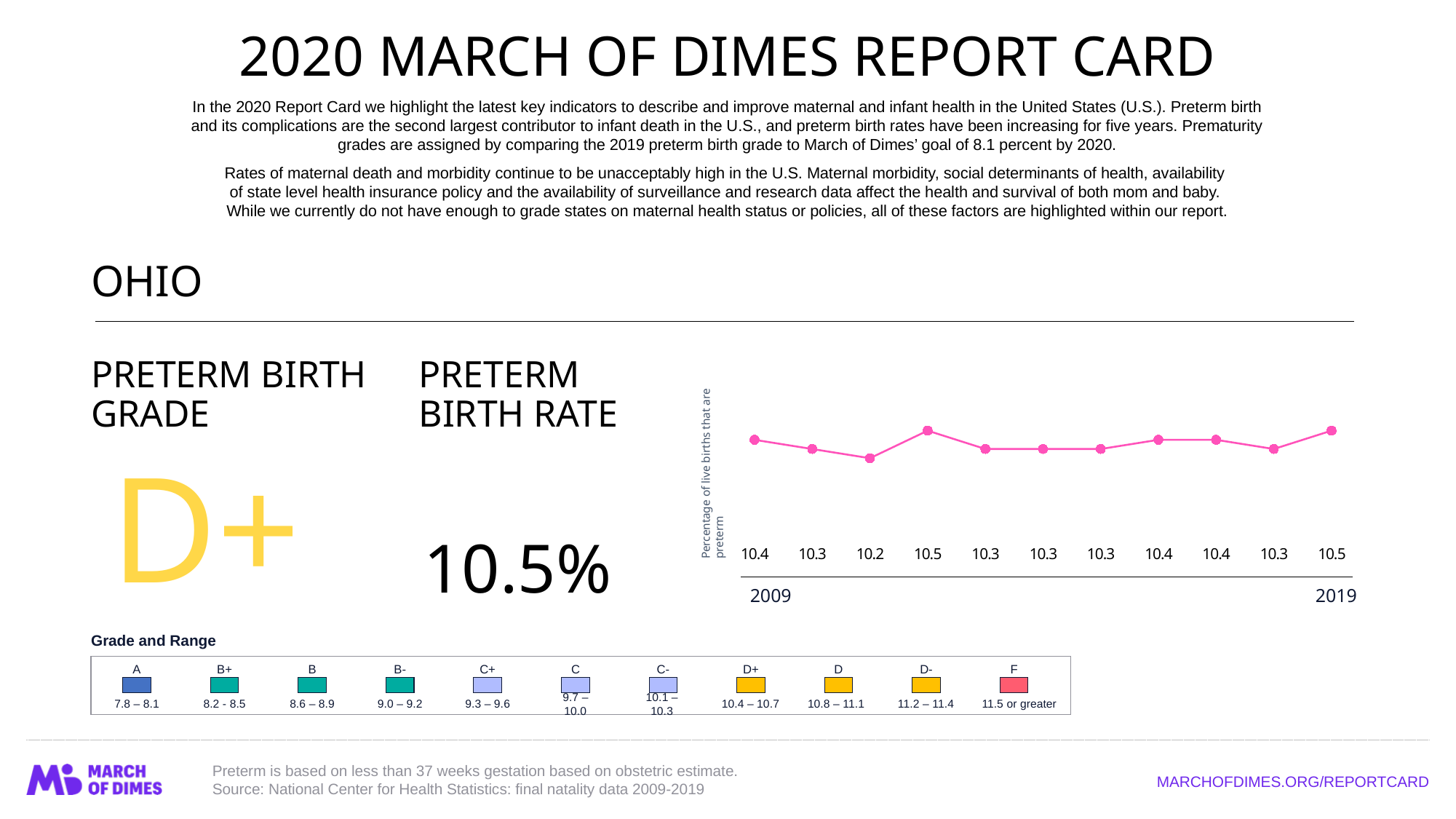
Which is larger in the line chart, the value for 2009 or the value for 2019? 2019 What is the lowest value plotted in the line chart? 10.2 What is the value of the third data point (from the left) in the line chart? 10.2 What is the difference between the 2019 value and the 2009 value in the line chart? 0.1 What is the preterm birth rate value plotted for 2009 in the line chart? 10.4 How many data points are plotted in the line chart? 11 What is the difference between the highest and lowest values plotted in the line chart? 0.3 What is the preterm birth rate value plotted for 2019 in the line chart? 10.5 What type of chart is shown on the slide? line chart What colour is the line in the chart? pink What is the highest value plotted in the line chart? 10.5 What is the y-axis label of the line chart? Percentage of live births that are preterm